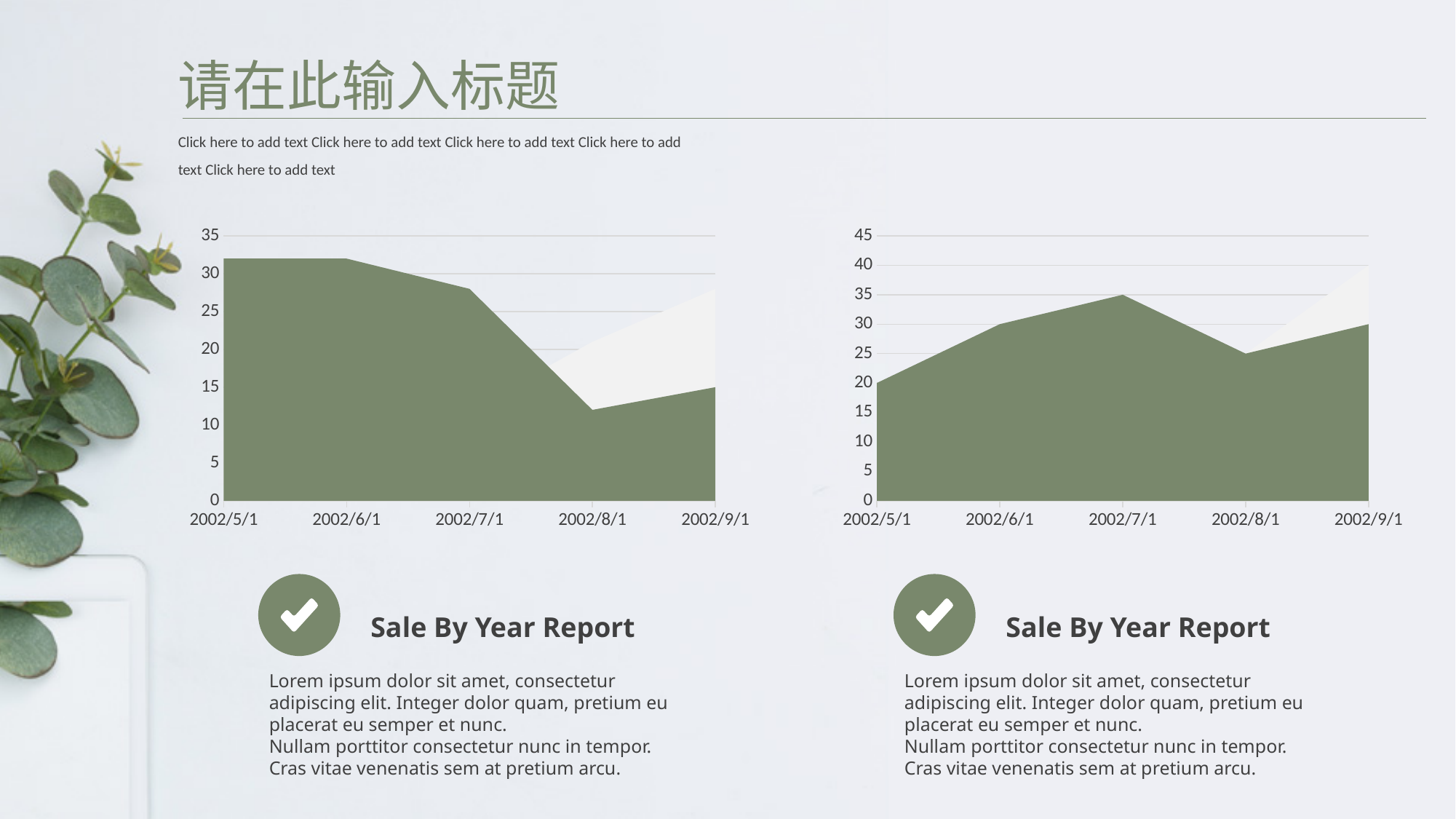
In the left chart, does the green series rise or fall from 2002/5/1 to 2002/8/1? fall In the right chart, which date has the highest value for the green series? 2002/7/1 In the right chart, is the value of the green series at 2002/8/1 greater or less than 30? less In the left chart, is the green series value at 2002/6/1 larger or smaller than at 2002/8/1? larger In the left chart, is the value of the green series at 2002/5/1 greater or less than 30? greater In the right chart, which date has the lowest value for the green series? 2002/5/1 What kind of chart is the left chart on the slide? area chart In the left chart, which date has the lowest value for the green series? 2002/8/1 In the right chart, what is the value of the green series at 2002/5/1? 20 In the left chart, is the value of the green series at 2002/8/1 greater or less than 15? less In the right chart, what is the value of the green series at 2002/7/1? 35 How many dates are shown on the x axis of the right chart? 5